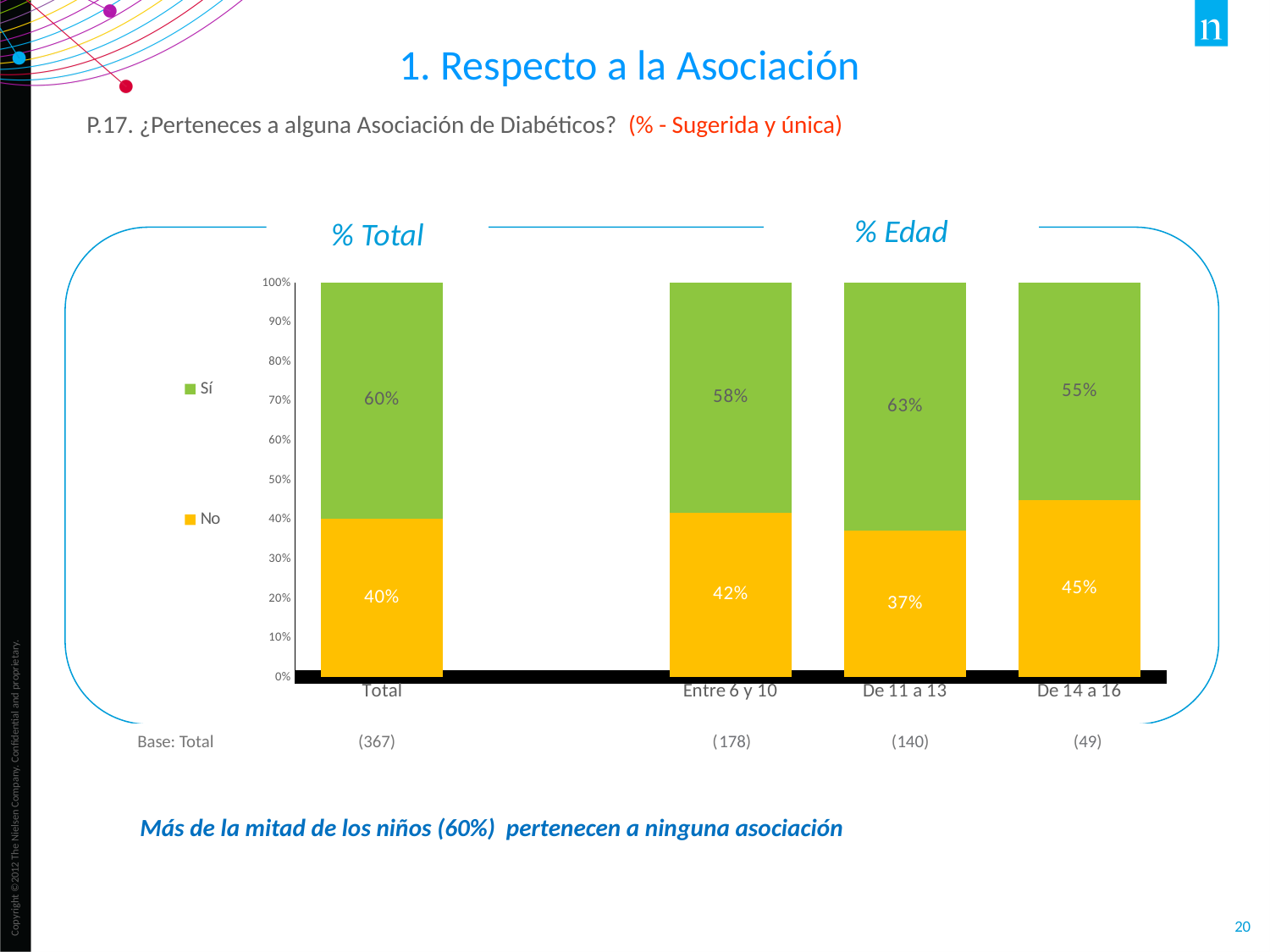
How many series does the legend list? 2 Which colour represents the Sí series in the legend? green What is the value of the No series for the Entre 6 y 10 category? 42% What is the difference between the Sí values for De 11 a 13 and De 14 a 16? 8% Which category has the highest value for the Sí series? De 11 a 13 What is the value of the Sí series for the Total category? 60% What is the value of the No series for the De 14 a 16 category? 45% How many categories are shown on the x axis? 4 What kind of chart is shown on the slide? stacked bar chart Which is larger: the No value for Entre 6 y 10 or the No value for De 14 a 16? De 14 a 16 Which category has the lowest value for the No series? De 11 a 13 What is the value of the Sí series for the De 11 a 13 category? 63%